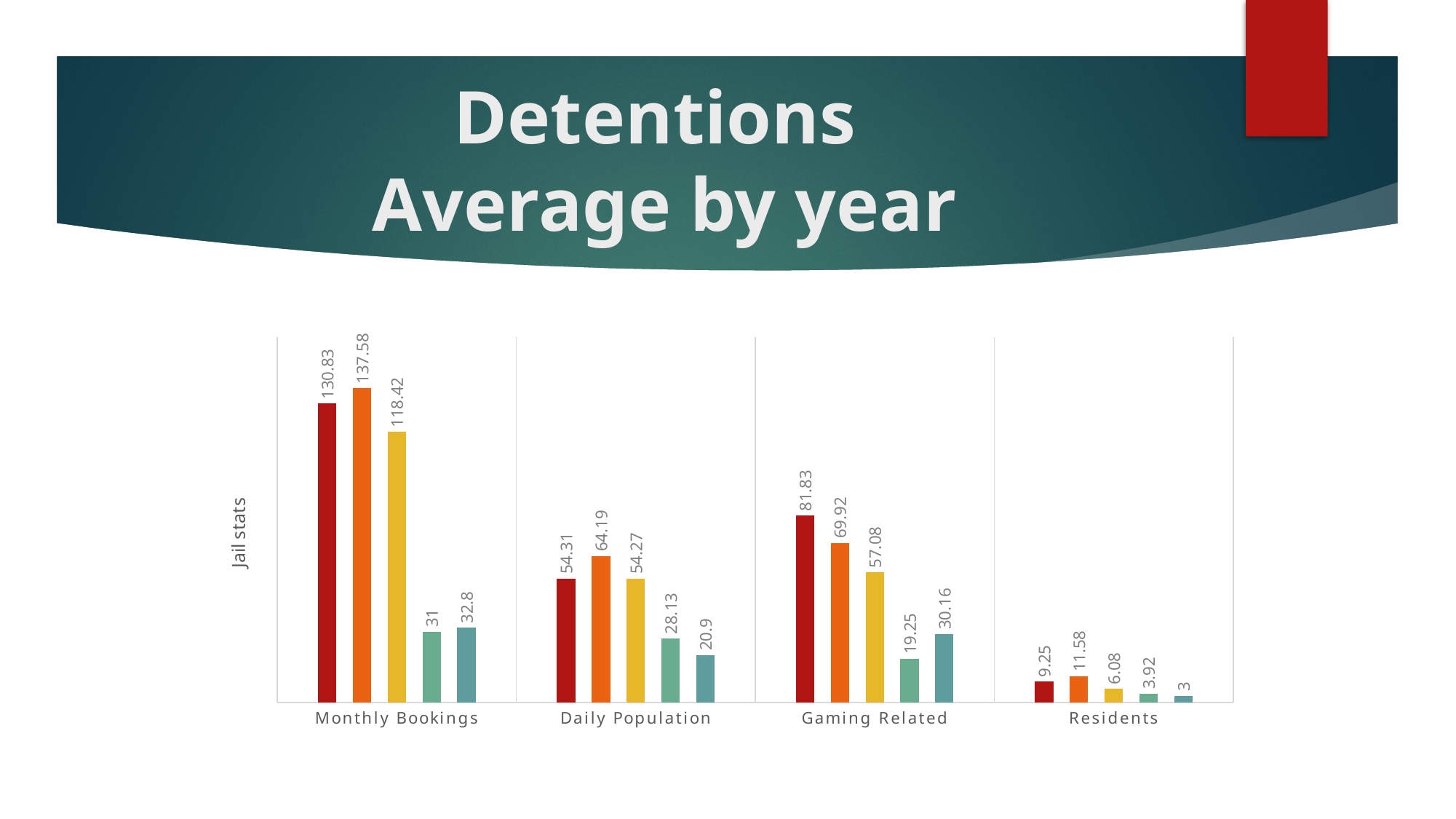
What is the value of the orange (second) bar for Monthly Bookings? 137.58 What is the value of the teal (last) bar for Residents? 3 What is the label on the vertical axis of the chart? Jail stats Which is larger for Gaming Related: the light green (fourth) bar or the teal (fifth) bar? the teal (fifth) bar How many categories are shown on the x axis of the chart? 4 Which category has the highest single bar value in the chart? Monthly Bookings What is the value of the dark red (first) bar for Gaming Related? 81.83 What is the difference between the orange bar and the dark red bar for Monthly Bookings? 6.75 What type of chart is shown on the slide? bar chart Which category has the lowest single bar value in the chart? Residents What is the value of the yellow (third) bar for Daily Population? 54.27 How many bars are plotted for each category in the chart? 5